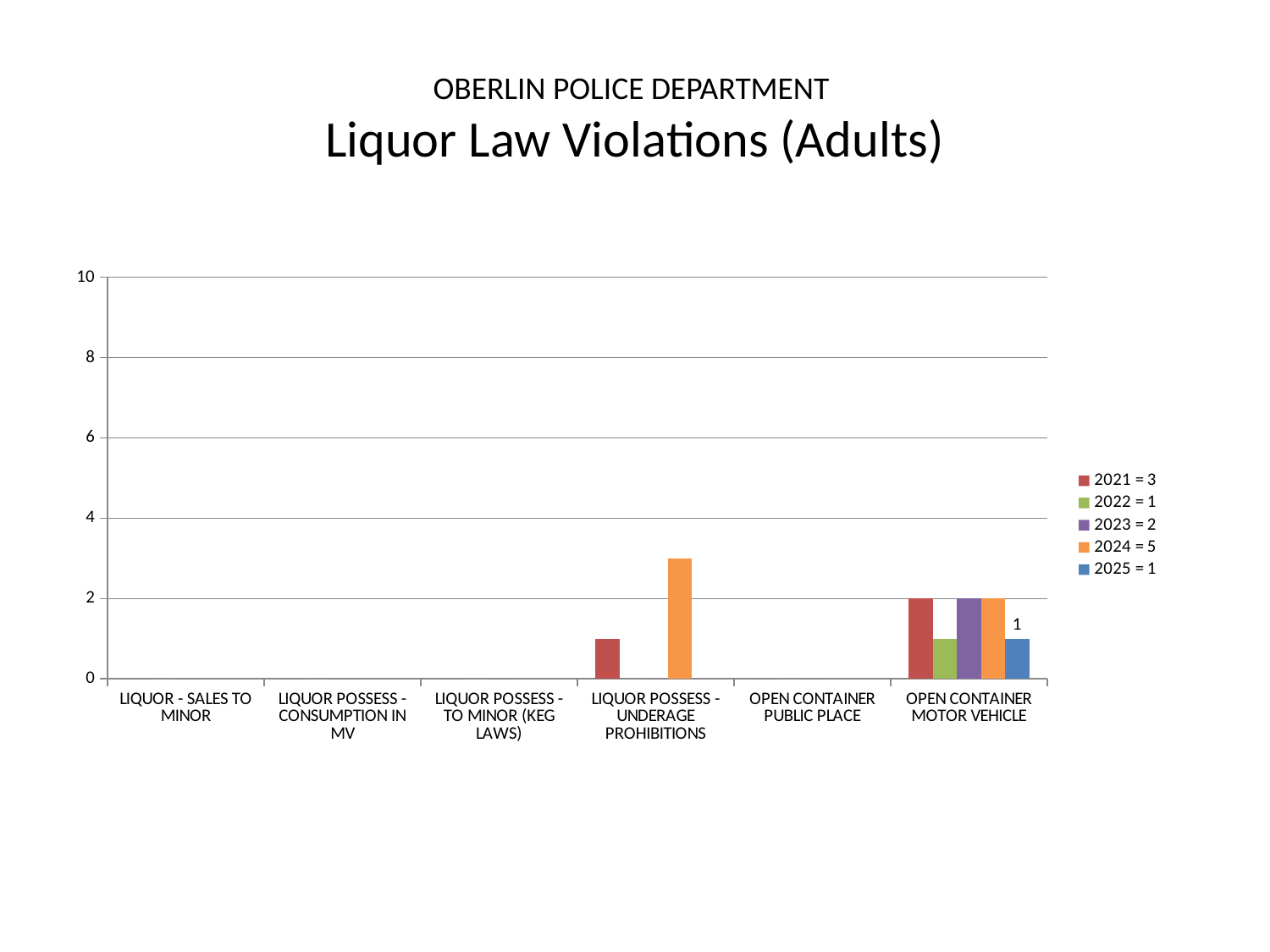
What is the 2023 value for OPEN CONTAINER MOTOR VEHICLE? 2 How many series does the legend list? 5 Is the 2021 value for LIQUOR POSSESS - UNDERAGE PROHIBITIONS greater or less than 2? less Which is larger: the 2024 bar for LIQUOR POSSESS - UNDERAGE PROHIBITIONS or the 2024 bar for OPEN CONTAINER MOTOR VEHICLE? LIQUOR POSSESS - UNDERAGE PROHIBITIONS Which category contains the tallest bar on the chart? LIQUOR POSSESS - UNDERAGE PROHIBITIONS How many categories are shown along the x axis? 6 According to the legend, what is the total for 2024? 5 What is the 2021 value for OPEN CONTAINER MOTOR VEHICLE? 2 Is the 2024 value for LIQUOR POSSESS - UNDERAGE PROHIBITIONS greater or less than 2? greater What kind of chart is shown on the slide? Bar chart What is the difference between the 2021 and 2025 values for OPEN CONTAINER MOTOR VEHICLE? 1 What is the 2025 value for OPEN CONTAINER MOTOR VEHICLE? 1